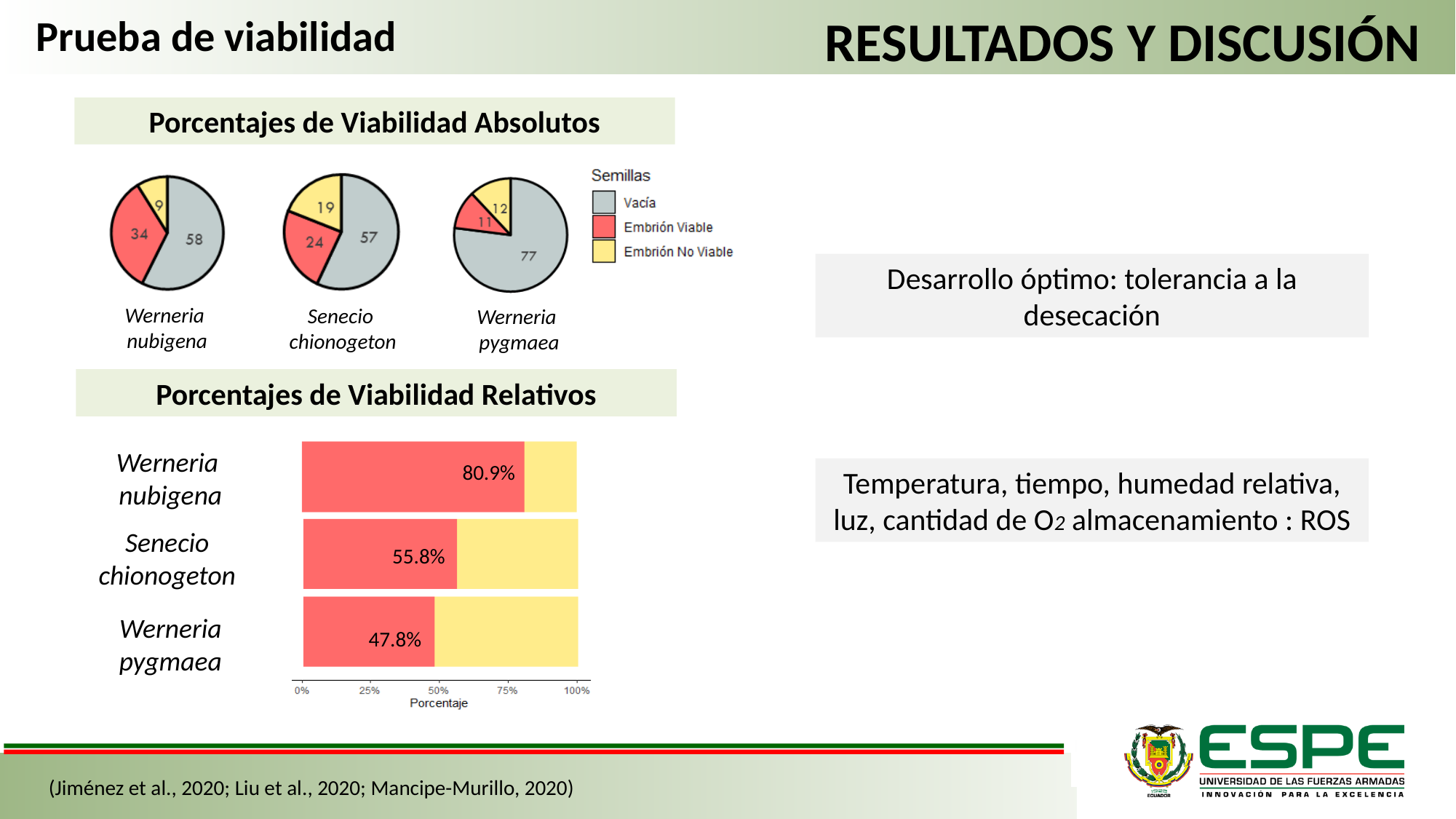
In the Porcentajes de Viabilidad Absolutos pie charts, which species has the largest Vacía slice? Werneria pygmaea In the Porcentajes de Viabilidad Absolutos pie charts, what is the Embrión Viable value for Senecio chionogeton? 24 What type of chart is used for Porcentajes de Viabilidad Relativos? Bar chart In the Porcentajes de Viabilidad Absolutos pie charts, what is the Embrión No Viable value for Werneria pygmaea? 12 In the Porcentajes de Viabilidad Relativos chart, which species has the highest labelled percentage? Werneria nubigena In the Porcentajes de Viabilidad Absolutos pie charts, what is the difference between the Embrión Viable values of Werneria nubigena and Senecio chionogeton? 10 How many categories does the Semillas legend list for the Porcentajes de Viabilidad Absolutos pie charts? 3 In the Porcentajes de Viabilidad Absolutos pie charts, what is the Vacía value for Werneria nubigena? 58 In the Porcentajes de Viabilidad Absolutos pie charts, which species has the smallest Embrión Viable slice? Werneria pygmaea In the Porcentajes de Viabilidad Relativos chart, is the labelled value for Werneria pygmaea greater or less than 50%? less In the Porcentajes de Viabilidad Relativos chart, what is the labelled value for Senecio chionogeton? 55.8% In the Porcentajes de Viabilidad Relativos chart, what is the difference between the labelled values of Werneria nubigena and Werneria pygmaea? 33.1%